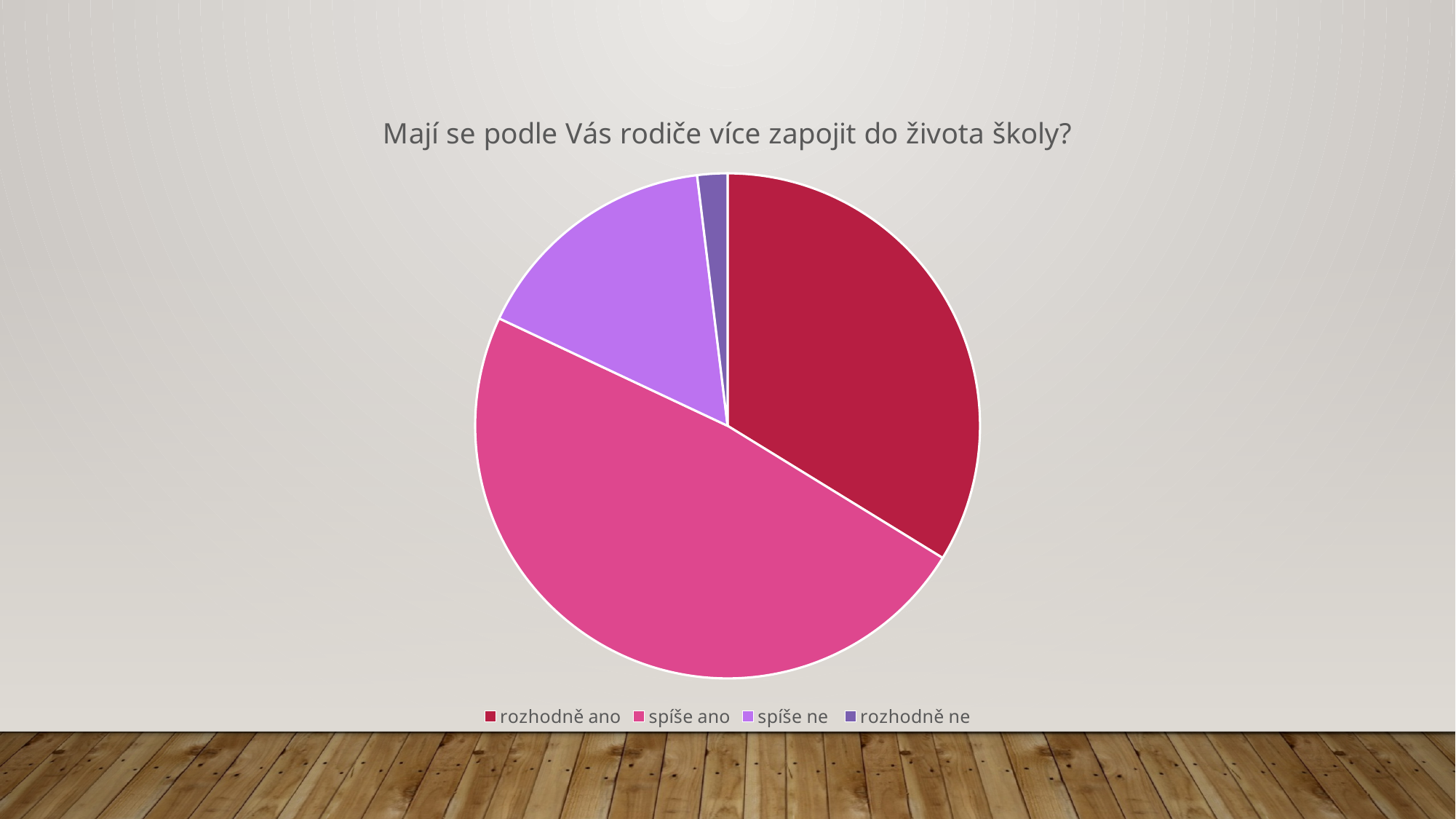
How many slices does the pie chart have? 4 What is the title of the chart? Mají se podle Vás rodiče více zapojit do života školy? Which legend entry is shown in the darkest red colour? rozhodně ano Which slice is larger, spíše ne or rozhodně ne? spíše ne What kind of chart is shown on the slide? pie chart Which slice is larger, rozhodně ano or spíše ne? rozhodně ano How many entries does the legend list? 4 Which category has the smallest slice of the pie? rozhodně ne Which slice is larger, spíše ano or rozhodně ano? spíše ano Which category has the largest slice of the pie? spíše ano